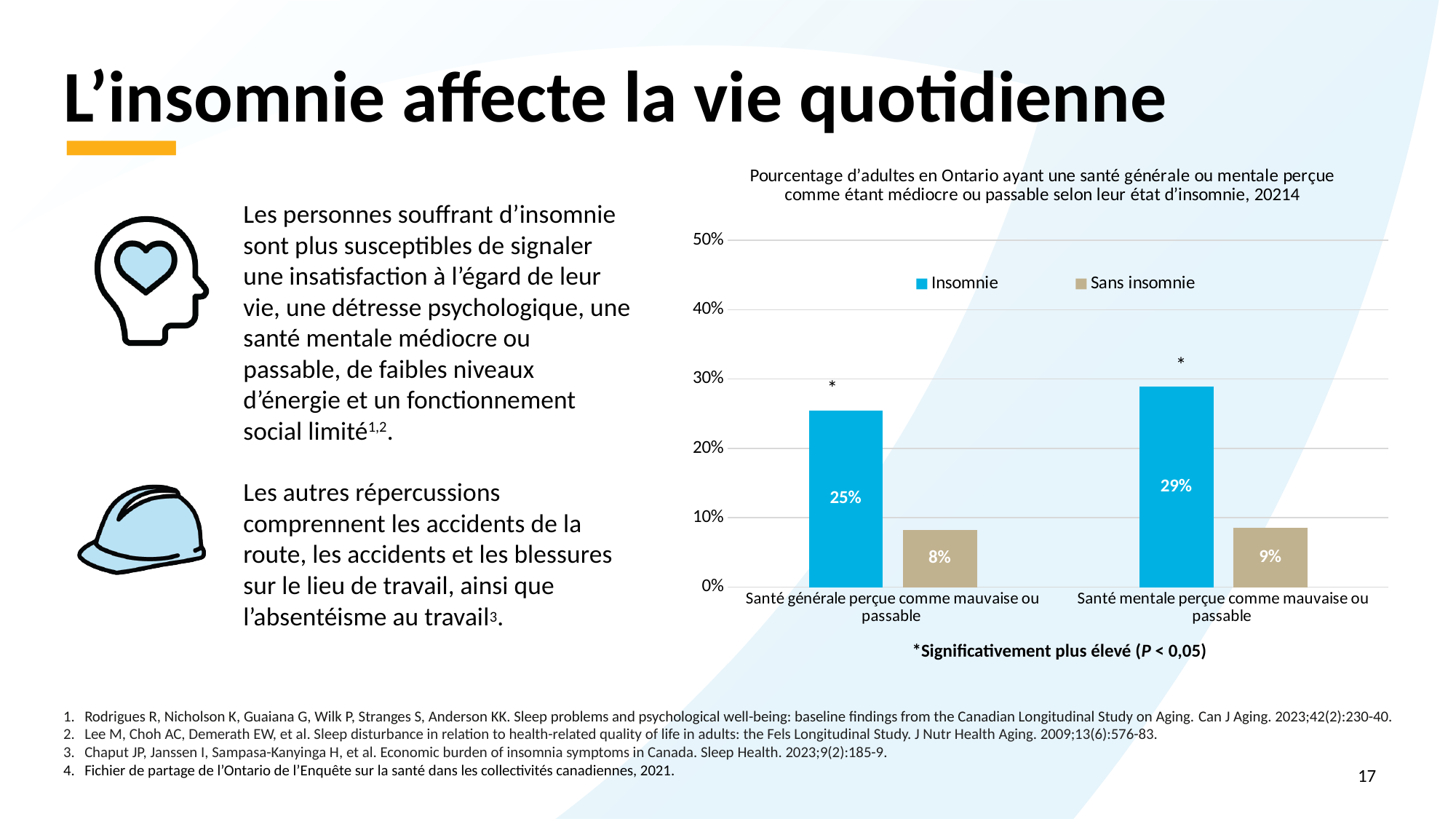
Is the Insomnie value for 'Santé mentale perçue comme mauvaise ou passable' greater or less than 20%? greater Which colour represents the Insomnie series in the chart? Blue What is the value for Sans insomnie in the 'Santé générale perçue comme mauvaise ou passable' category? 8% How many categories are shown on the x axis of the chart? 2 Which bar on the chart has the lowest value? Sans insomnie, Santé générale perçue comme mauvaise ou passable Which is larger: the Insomnie value for 'Santé générale perçue comme mauvaise ou passable' or the Insomnie value for 'Santé mentale perçue comme mauvaise ou passable'? Santé mentale perçue comme mauvaise ou passable What is the value for Insomnie in the 'Santé générale perçue comme mauvaise ou passable' category? 25% What is the value for Sans insomnie in the 'Santé mentale perçue comme mauvaise ou passable' category? 9% What kind of chart is shown on the slide? Bar chart Which series has the highest value in the 'Santé mentale perçue comme mauvaise ou passable' category? Insomnie How many series does the chart legend list? 2 What is the difference between the Insomnie and Sans insomnie values for 'Santé mentale perçue comme mauvaise ou passable'? 20%